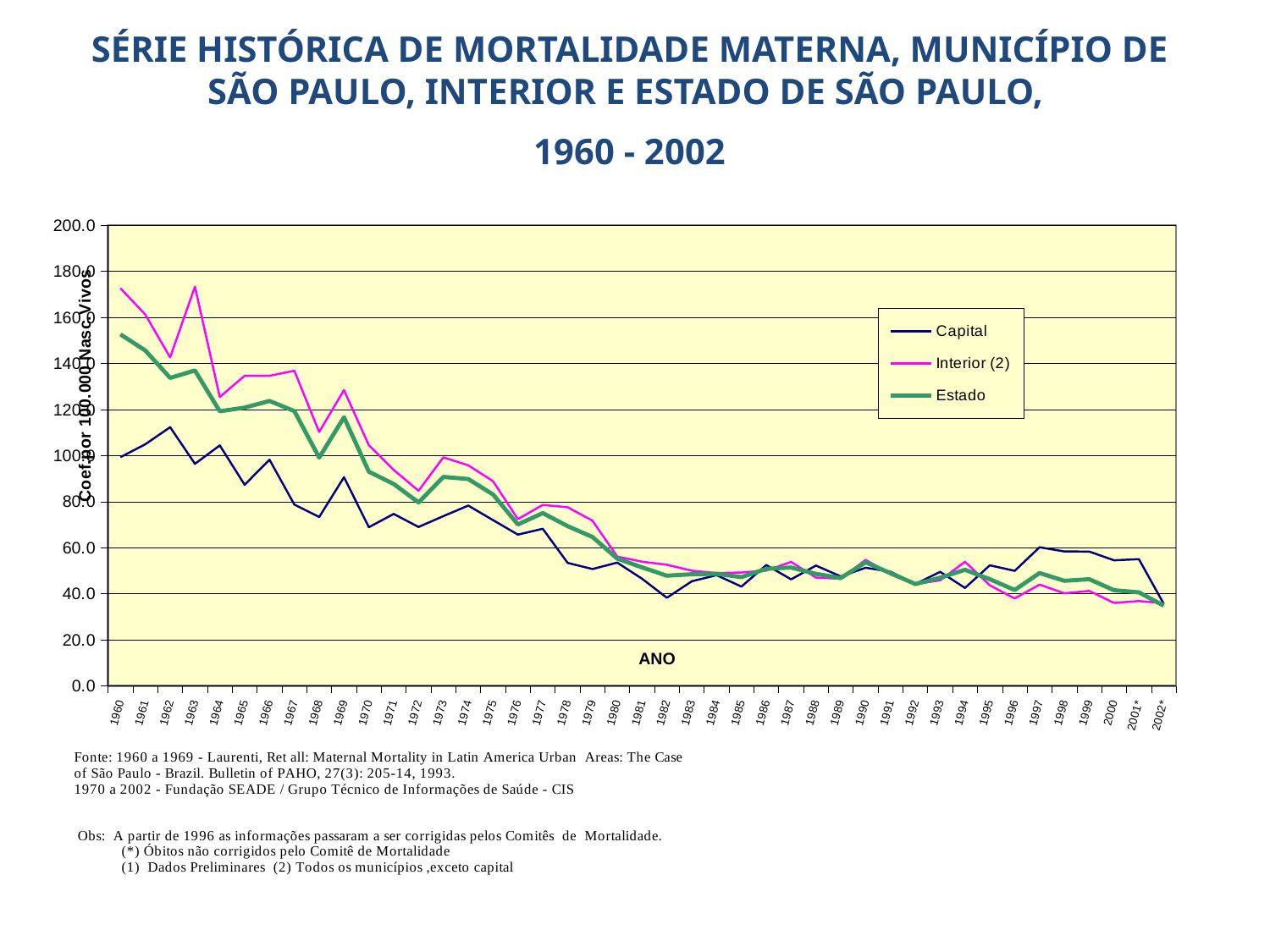
Which series are listed in the legend? Capital, Interior (2), Estado What is the label of the x axis? ANO In 1963, which is larger, the value for Interior (2) or the value for Estado? Interior (2) Is the value for Capital in 1962 greater or less than 100? greater What kind of chart is shown on the slide? line chart How many years are plotted along the x axis? 43 Is the value for Capital in 1970 greater or less than 80? less How many series does the legend list? 3 Is the value for Interior (2) in 1960 greater or less than 160? greater Does the Estado series rise or fall from 1960 to 2002? fall Which series has the highest value in 1960? Interior (2)